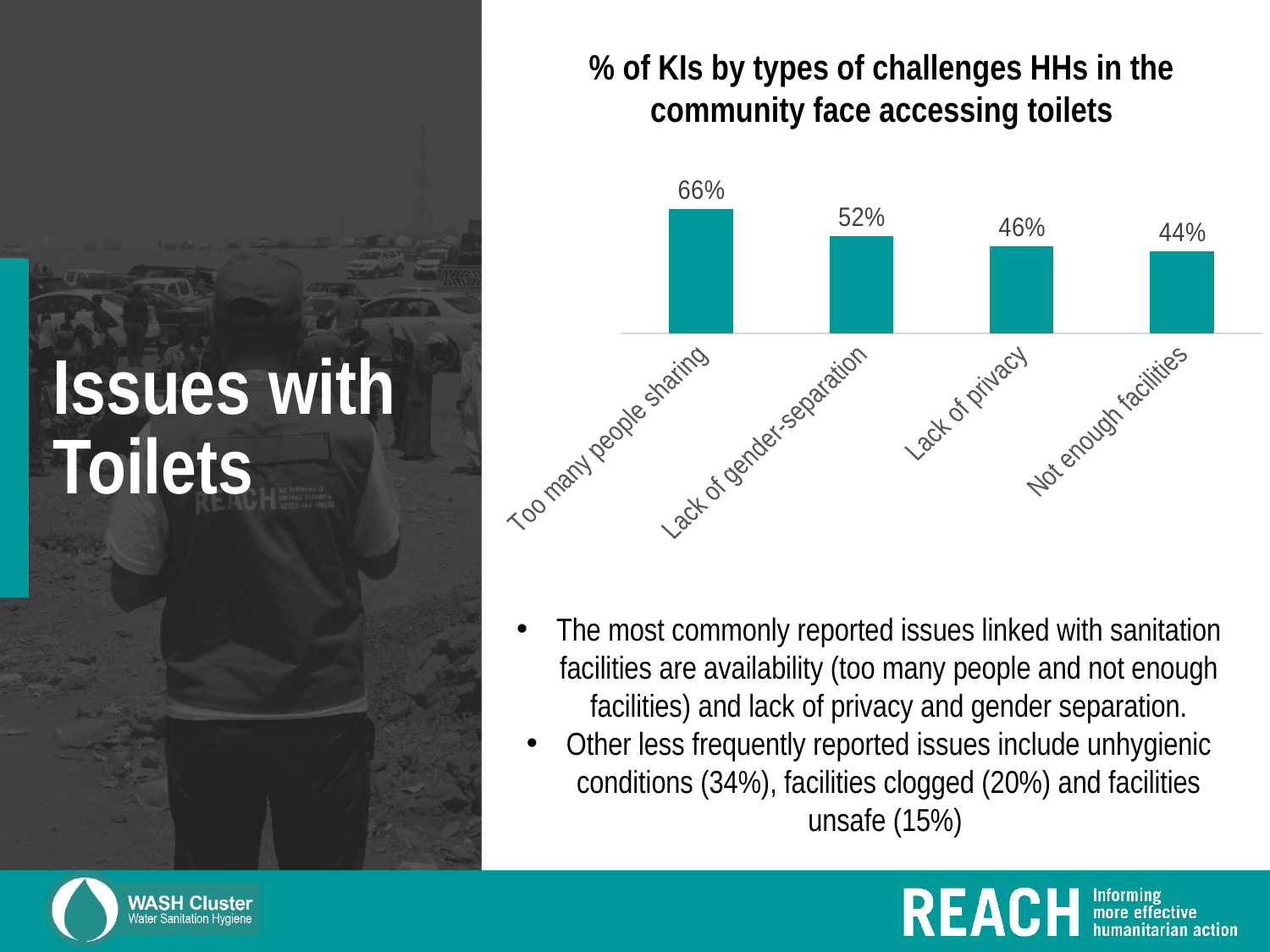
What is the title of the chart? % of KIs by types of challenges HHs in the community face accessing toilets What percentage of KIs reported 'Lack of gender-separation' as a challenge? 52% What is the difference in percentage points between 'Lack of gender-separation' and 'Lack of privacy'? 6 What percentage of KIs reported 'Not enough facilities' as a challenge? 44% What is the difference in percentage points between 'Too many people sharing' and 'Not enough facilities'? 22 Which challenge was reported by the lowest percentage of KIs? Not enough facilities What percentage of KIs reported 'Lack of privacy' as a challenge? 46% What percentage of KIs reported 'Too many people sharing' as a challenge in accessing toilets? 66% What type of chart is used to show the challenges in accessing toilets? Bar chart How many types of challenges are shown in the chart? 4 Which was reported by more KIs: 'Lack of gender-separation' or 'Lack of privacy'? Lack of gender-separation Which challenge was reported by the highest percentage of KIs? Too many people sharing